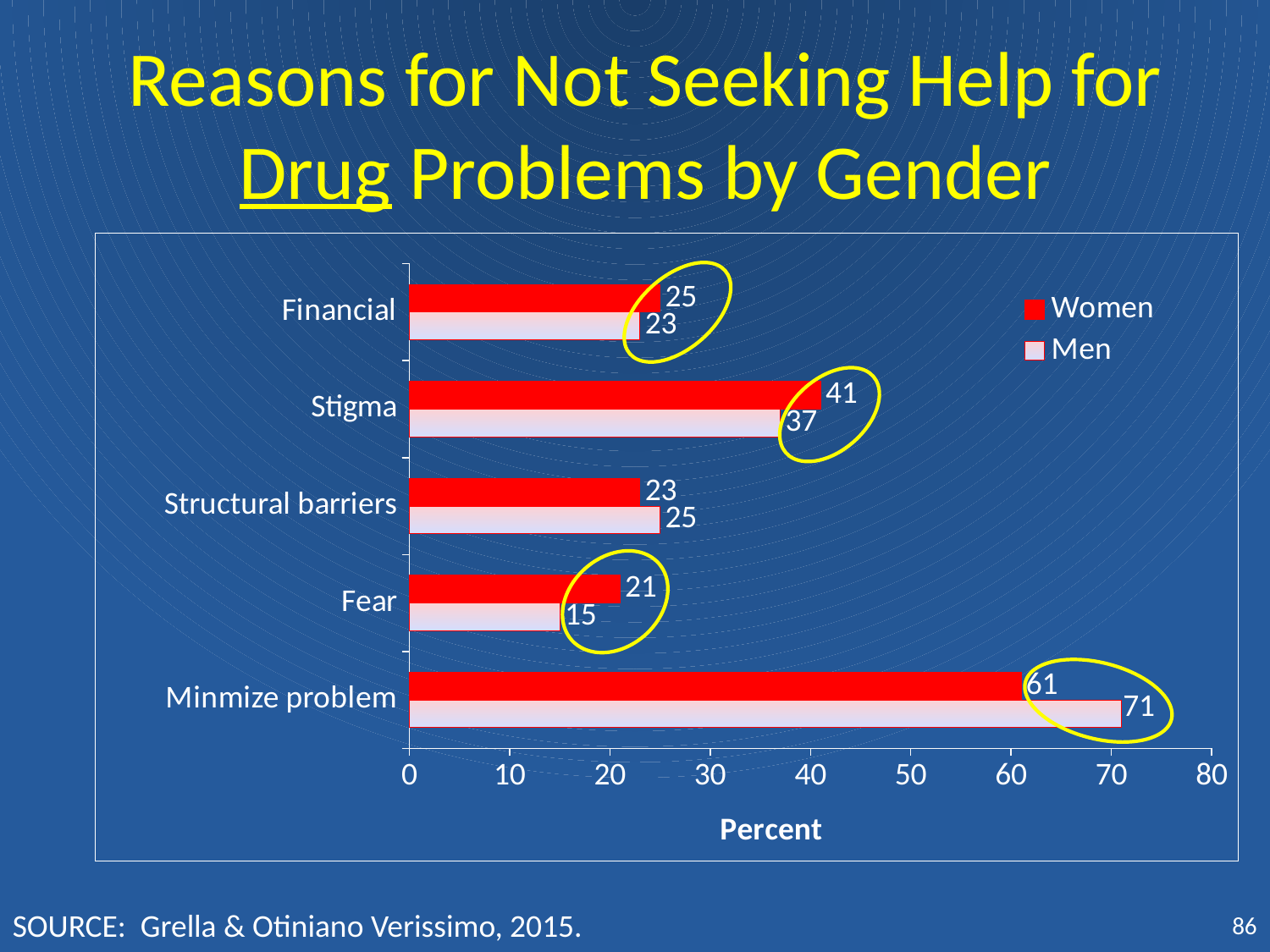
What is the value for Men for Fear? 15 Is the value for Men for Stigma greater or less than 30? greater What is the difference between the Men and Women values for Minmize problem? 10 How many categories are shown on the chart? 5 What is the label of the horizontal axis? Percent What kind of chart is shown on the slide? bar chart Which category has the highest value for Women? Minmize problem Which category has the lowest value for Men? Fear What is the value for Women for Stigma? 41 Which is larger for Stigma, the Women value or the Men value? Women How many series does the legend list? 2 What is the value for Men for Minmize problem? 71